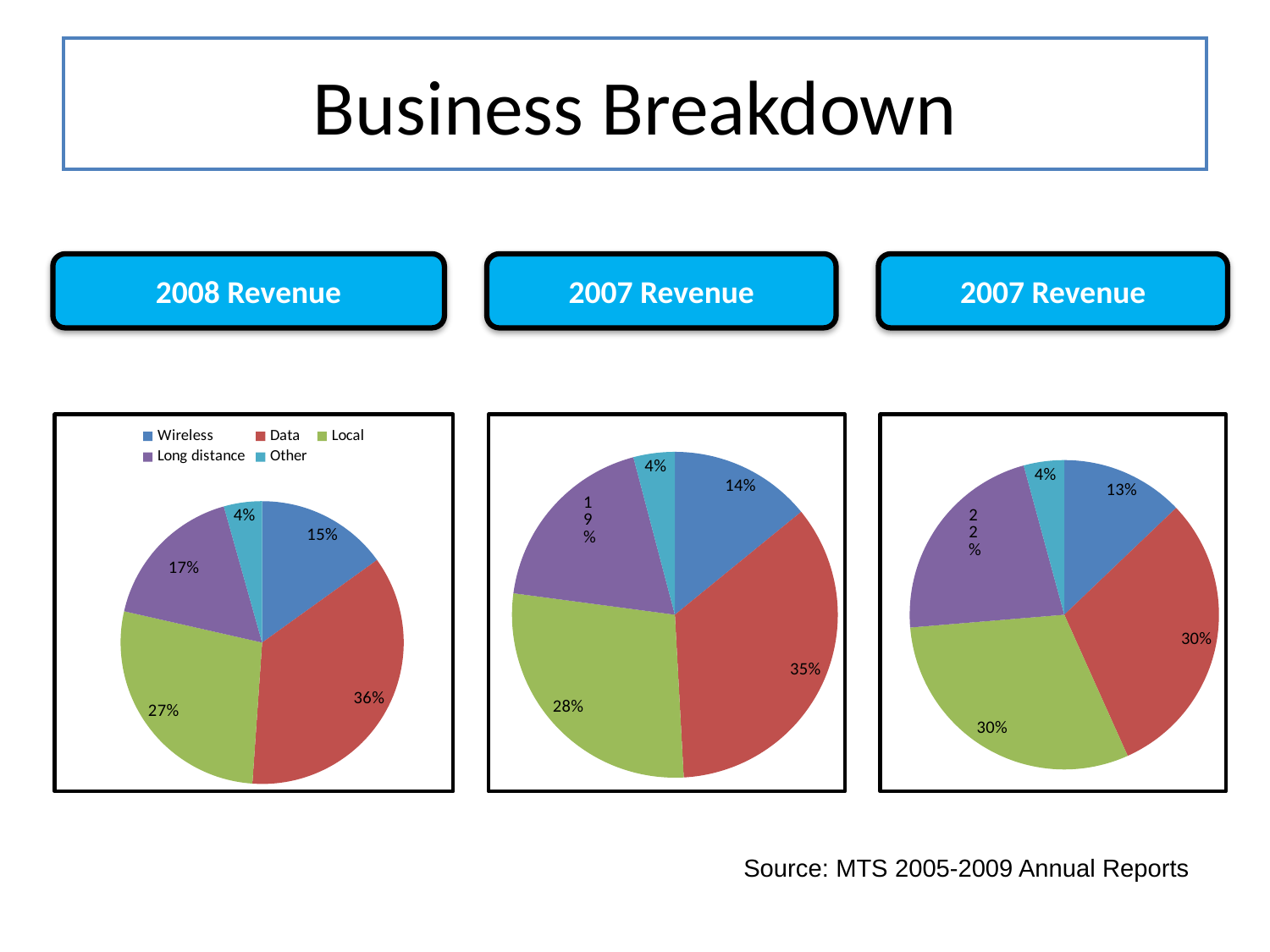
How many slices does the pie chart on the right of the slide have? 5 In the middle pie chart, how many percentage points larger is the largest slice (35%) than the 28% slice? 7 percentage points In the 2008 Revenue chart on the left, what share of revenue does Data account for? 36% In the middle pie chart, what is the value of the largest slice? 35% In the 2008 Revenue chart on the left, which is larger: the Wireless share or the Long distance share? Long distance In the 2008 Revenue chart on the left, which category has the smallest share? Other In the 2008 Revenue chart on the left, how many percentage points larger is the Data share than the Local share? 9 percentage points In the 2008 Revenue chart on the left, which category has the largest share? Data What kind of chart is the 2008 Revenue chart on the left of the slide? pie chart In the 2008 Revenue chart on the left, what share of revenue does Local account for? 27% In the 2008 Revenue chart on the left, what share of revenue does Long distance account for? 17% How many categories does the legend of the 2008 Revenue chart on the left list? 5